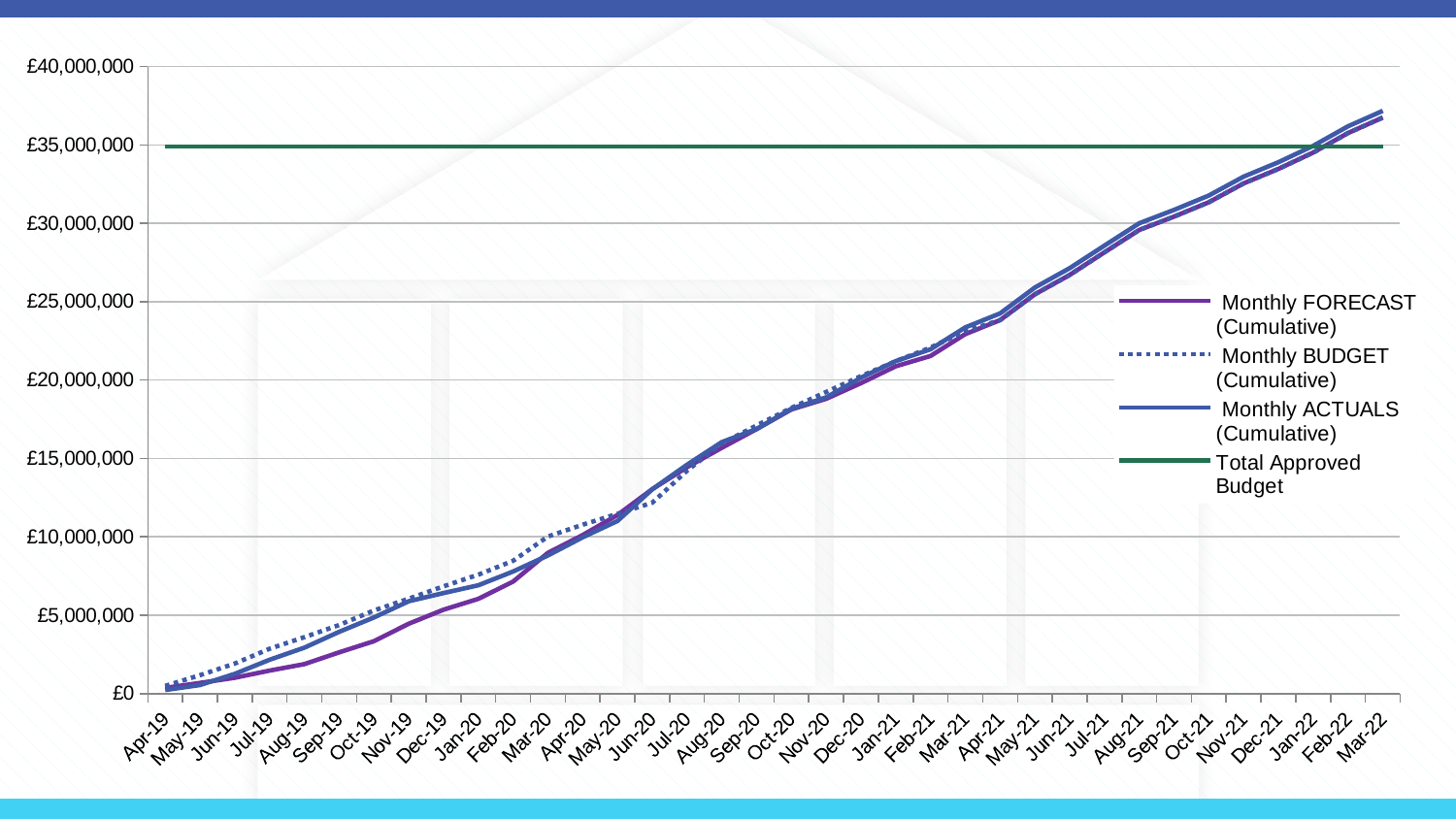
At Aug-19, which is higher: Monthly BUDGET (Cumulative) or Monthly FORECAST (Cumulative)? Monthly BUDGET (Cumulative) How many series does the legend list? 4 Do the Monthly ACTUALS (Cumulative) values rise or fall from Apr-19 to Mar-22? rise How many months are shown along the x axis? 36 Which series is drawn with a dotted line? Monthly BUDGET (Cumulative) Is the Monthly ACTUALS (Cumulative) value at Mar-22 greater or less than £35,000,000? greater Is the Monthly FORECAST (Cumulative) value at Oct-19 greater or less than £5,000,000? less Which series is drawn in green? Total Approved Budget What type of chart is shown on the slide? line chart What is the first month shown on the x axis? Apr-19 Is the Monthly ACTUALS (Cumulative) value at Jan-21 greater or less than £20,000,000? greater